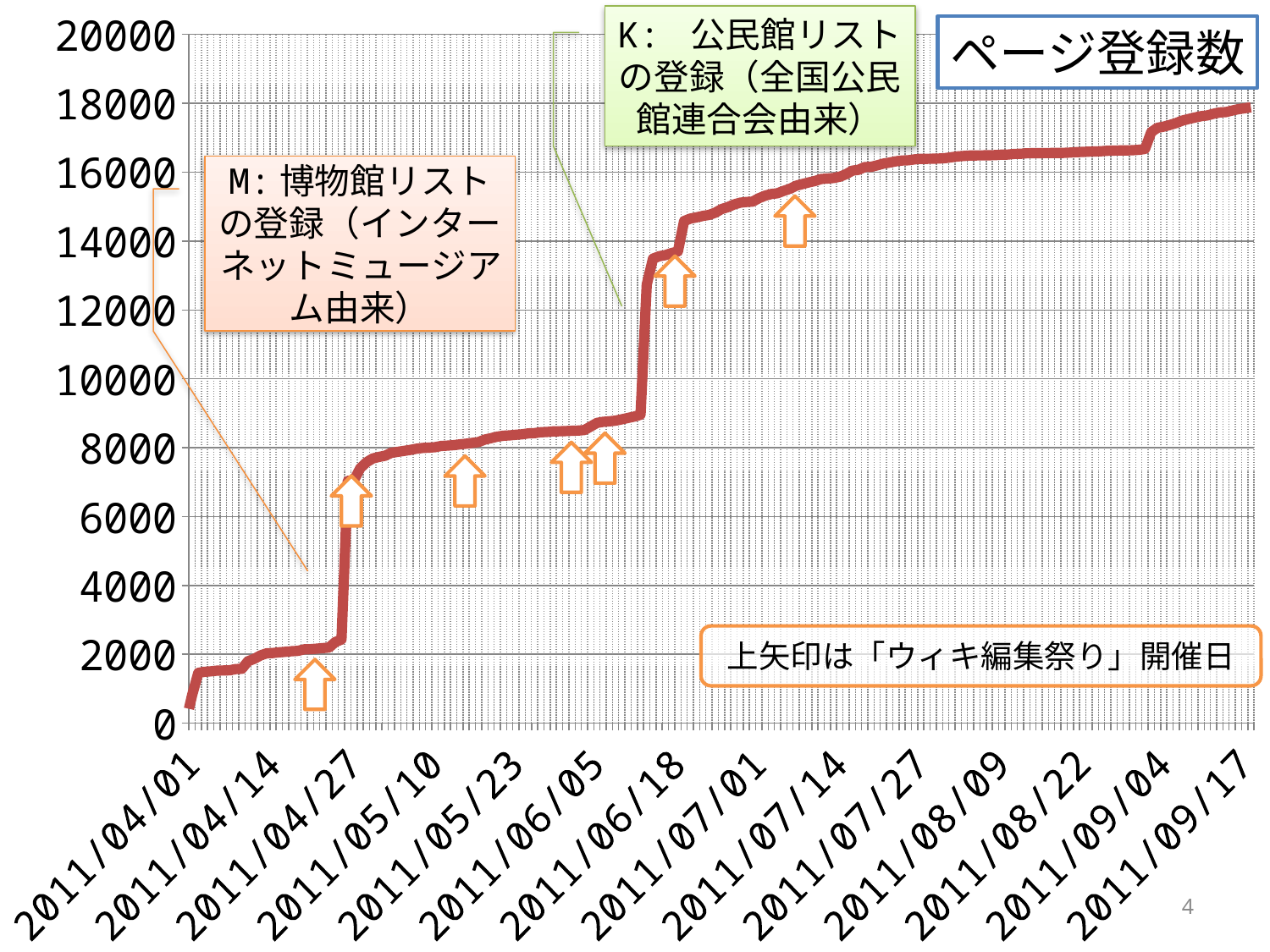
Is the value at 2011/04/01 greater or less than 2000? less What is the title of the chart? ページ登録数 At which x-axis date is the plotted value lowest? 2011/04/01 Is the value at 2011/06/05 greater or less than 10000? less How many date labels are shown on the x axis? 14 What kind of chart is shown on the slide? line chart Is the value at 2011/09/17 greater or less than 16000? greater Do the values generally rise or fall from 2011/04/01 to 2011/09/17? rise At which x-axis date is the plotted value highest? 2011/09/17